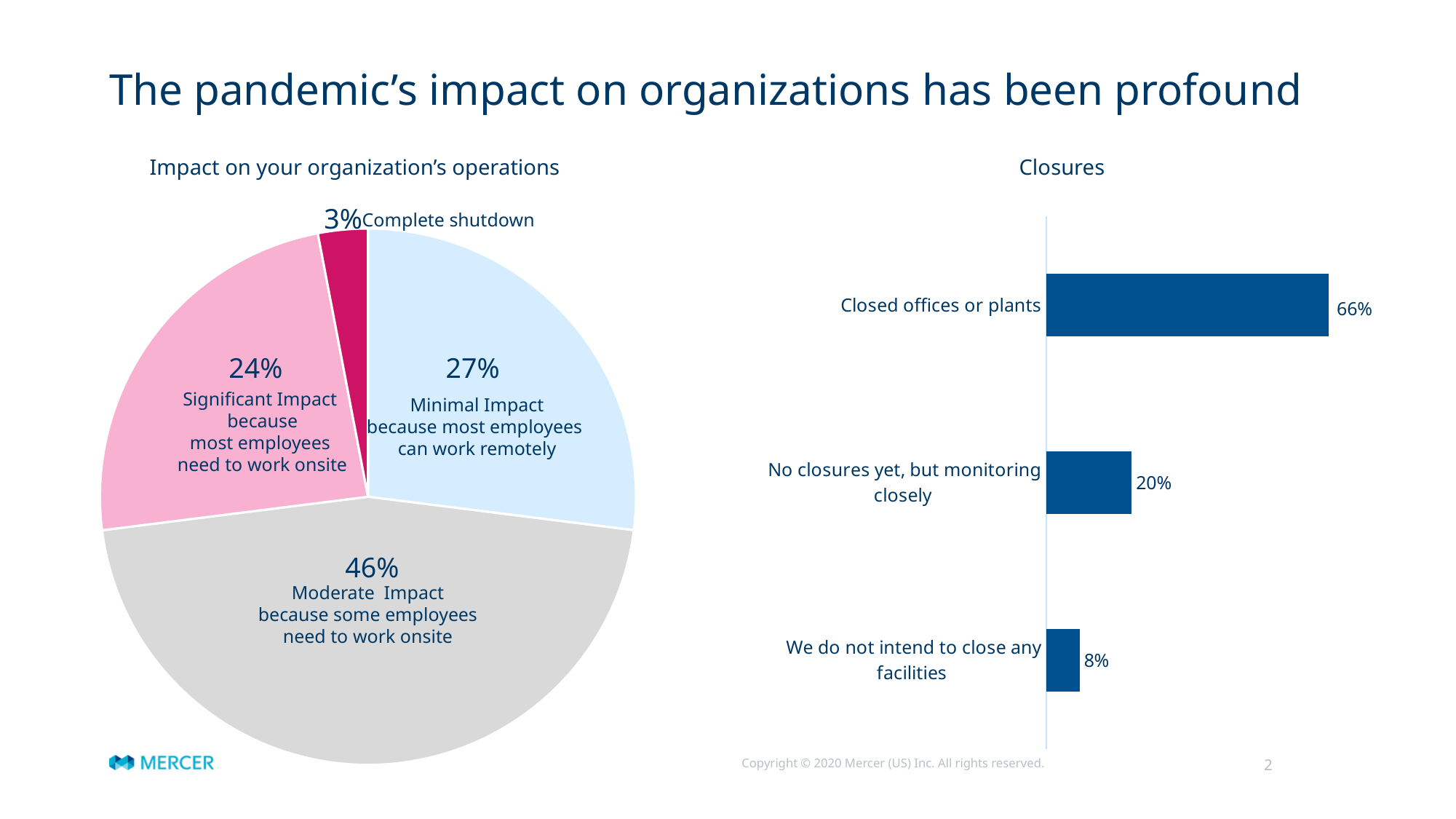
In the 'Impact on your organization's operations' pie chart, which slice is the largest? Moderate Impact because some employees need to work onsite In the 'Impact on your organization's operations' pie chart, which slice is the smallest? Complete shutdown In the 'Impact on your organization's operations' pie chart, how many slices are there? 4 What kind of chart is the 'Closures' chart? Bar chart In the 'Impact on your organization's operations' pie chart, which is larger: Minimal Impact or Significant Impact? Minimal Impact In the 'Impact on your organization's operations' pie chart, what is the difference between the Minimal Impact share and the Significant Impact share? 3% In the 'Impact on your organization's operations' pie chart, what share is labelled 'Complete shutdown'? 3% In the 'Impact on your organization's operations' pie chart, what share is 'Moderate Impact because some employees need to work onsite'? 46% In the 'Closures' chart, what is the value for 'Closed offices or plants'? 66% In the 'Closures' chart, how many categories are shown? 3 In the 'Closures' chart, what is the difference between 'Closed offices or plants' and 'No closures yet, but monitoring closely'? 46% In the 'Closures' chart, what is the value for 'We do not intend to close any facilities'? 8%